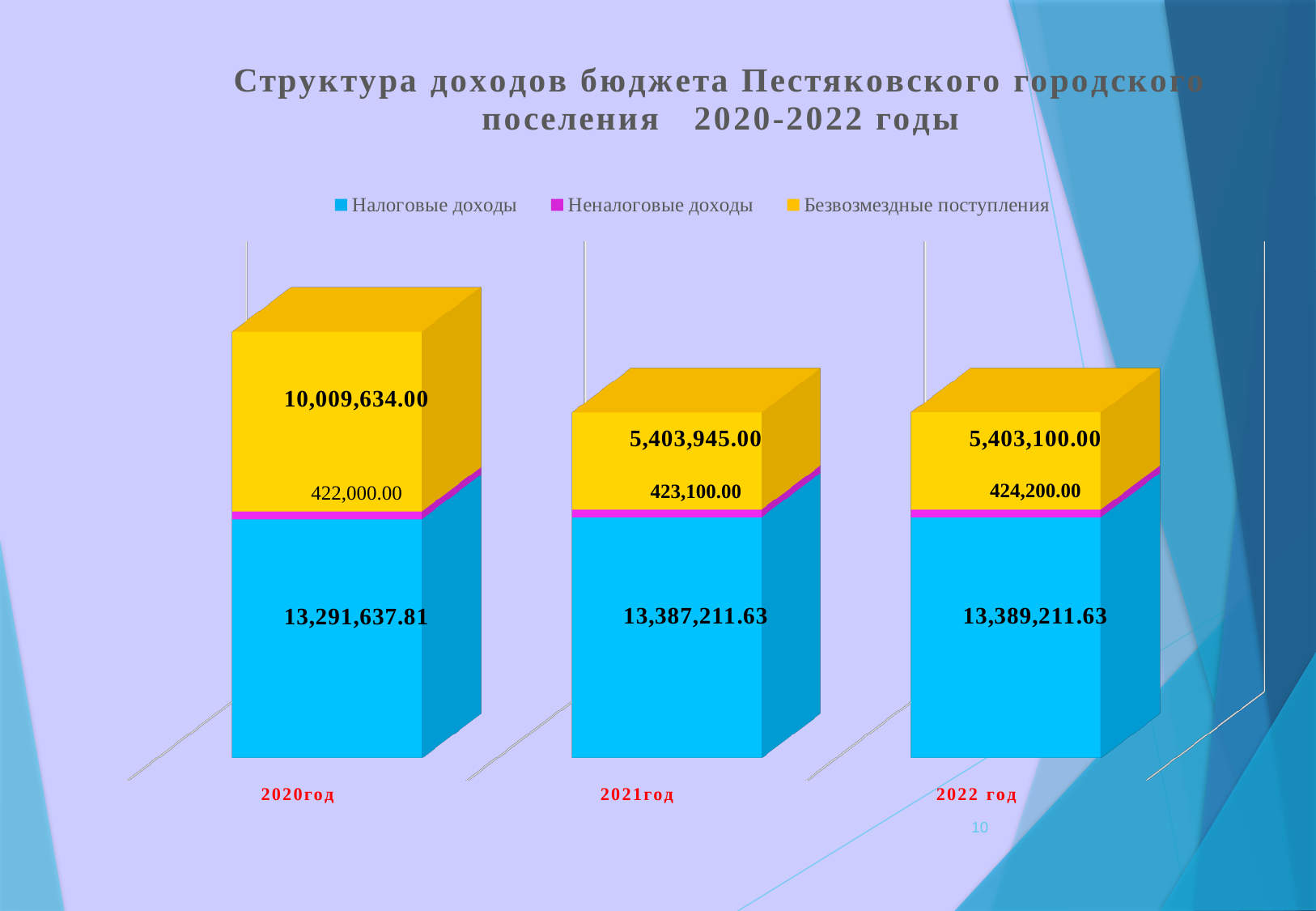
In which year is Безвозмездные поступления the highest? 2020год What is the value of Безвозмездные поступления for 2021год? 5,403,945.00 What is the value of Неналоговые доходы for 2022 год? 424,200.00 Do the values of Неналоговые доходы rise or fall from 2020год to 2022 год? rise What type of chart is shown on the slide? stacked bar chart In which year is Неналоговые доходы the lowest? 2020год Which is larger: Налоговые доходы in 2020год or Безвозмездные поступления in 2020год? Налоговые доходы in 2020год How many years (categories) are shown on the x axis? 3 How many series does the legend list? 3 What is the total of the stacked bar for 2021год? 19,214,256.63 What is the value of Налоговые доходы for 2020год? 13,291,637.81 What is the difference between Безвозмездные поступления in 2020год and 2021год? 4,605,689.00